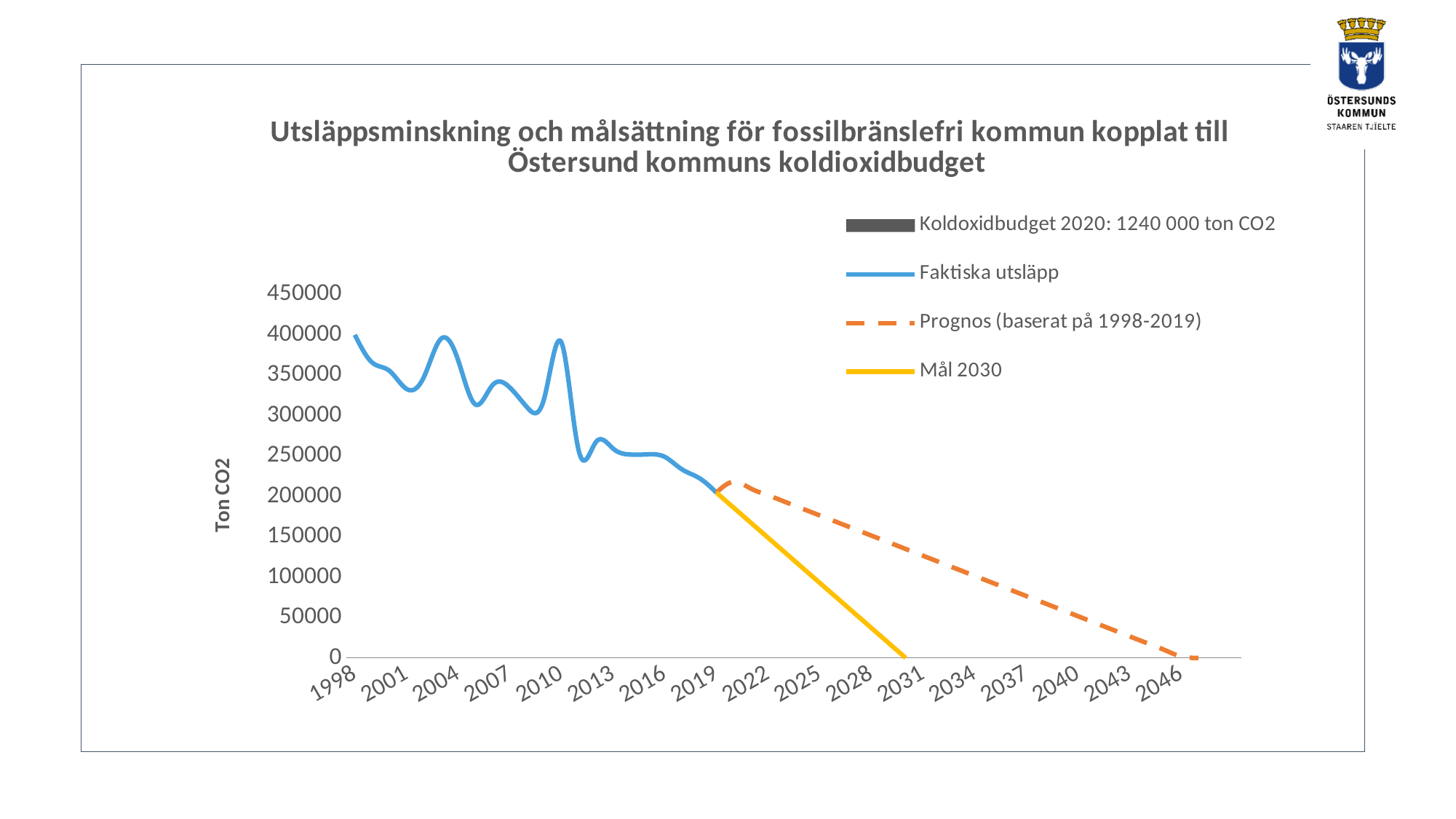
Which series reaches 0 first along the x axis: Mål 2030 or Prognos (baserat på 1998-2019)? Mål 2030 Is the Prognos (baserat på 1998-2019) value for 2040 greater or less than 100000? less What is the label on the vertical axis? Ton CO2 How many year labels are shown on the horizontal axis? 17 What kind of chart is shown on the slide? line chart How many series does the legend list? 4 Is the Faktiska utsläpp value for 1998 greater or less than 350000? greater Is the Faktiska utsläpp value for 2010 greater or less than 300000? greater In 2025, which series has the higher value: Prognos (baserat på 1998-2019) or Mål 2030? Prognos (baserat på 1998-2019) What is the first legend entry in the chart? Koldoxidbudget 2020: 1240 000 ton CO2 Do the Faktiska utsläpp values overall rise or fall from 1998 to 2019? fall